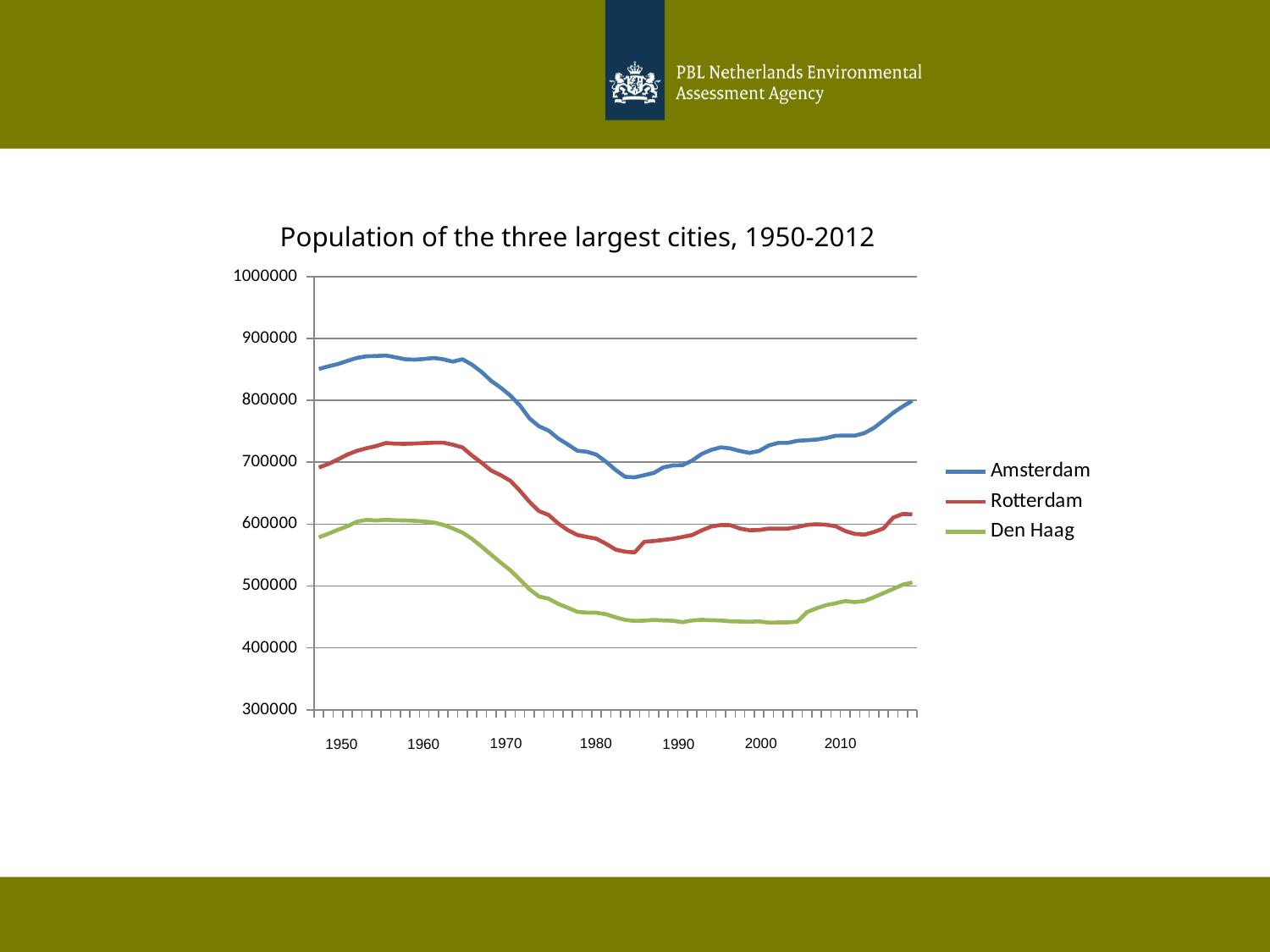
Is the population of Den Haag in 1990 greater or less than 500000? less Does the population of Amsterdam rise or fall between 1965 and 1985? fall Is the population of Rotterdam in 1960 greater or less than 700000? greater What is the title of the chart? Population of the three largest cities, 1950-2012 Is the population of Rotterdam in 1990 greater or less than 600000? less Which cities are listed in the legend? Amsterdam, Rotterdam, Den Haag What kind of chart is shown on the slide? line chart Which city had the larger population in 1980, Rotterdam or Den Haag? Rotterdam Which city has the highest population throughout the period shown? Amsterdam How many series does the legend list? 3 Which city has the lowest population throughout the period shown? Den Haag